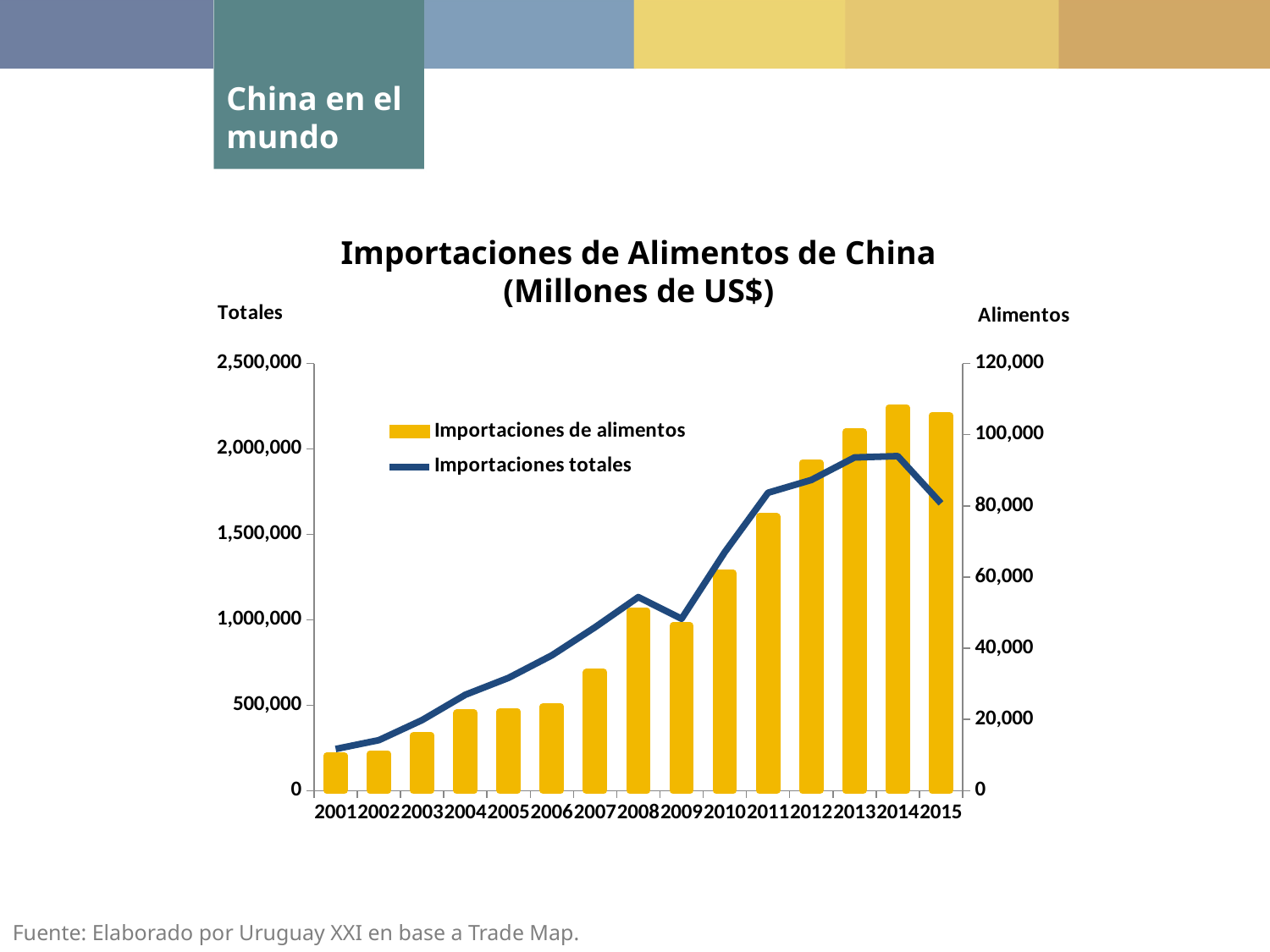
What kind of chart is shown on the slide? A combination bar and line chart Which year has the lowest value for Importaciones de alimentos? 2001 Which year has the lowest value for Importaciones totales? 2001 What is the title of the chart? Importaciones de Alimentos de China (Millones de US$) How many series does the legend list? 2 Is the value for Importaciones de alimentos in 2008 greater or less than 40,000? greater Do the values for Importaciones de alimentos generally rise or fall from 2001 to 2014? rise Which year has the larger value for Importaciones totales, 2008 or 2009? 2008 How many years are shown on the x axis of the chart? 15 Is the value for Importaciones totales in 2015 greater or less than 2,000,000? less Which series is drawn as bars in the chart? Importaciones de alimentos Is the value for Importaciones de alimentos in 2012 greater or less than 80,000? greater